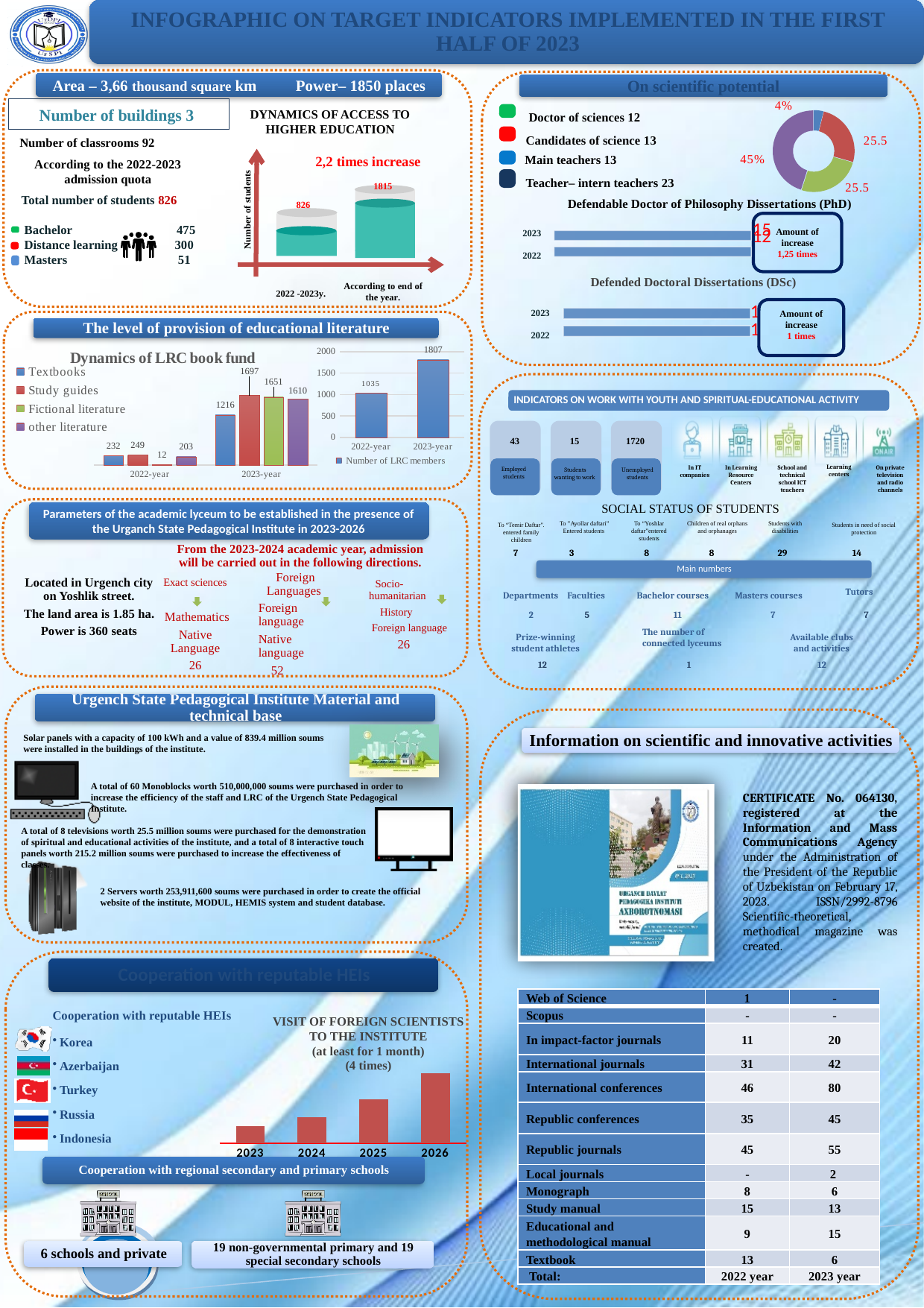
In the 'Dynamics of LRC book fund' chart, what is the value for Fictional literature in 2022-year? 12 In the 'Visit of foreign scientists to the institute' chart, do the values rise or fall from 2023 to 2026? rise In the 'Dynamics of LRC book fund' chart, which category has the highest value in 2023-year? Study guides What kind of chart is the 'Number of LRC members' chart? bar chart In the 'Number of LRC members' chart, what is the difference between 2023-year and 2022-year? 772 In the 'Dynamics of LRC book fund' chart, what is the difference between Textbooks in 2023-year and Textbooks in 2022-year? 984 In the 'Dynamics of access to higher education' chart, what is the value for 2022-2023y.? 826 How many series does the legend of the 'Dynamics of LRC book fund' chart list? 4 In the 'Dynamics of LRC book fund' chart, what is the value for Study guides in 2023-year? 1697 In the 'Dynamics of LRC book fund' chart, which category has the lowest value in 2022-year? Fictional literature In the 'Number of LRC members' chart, what is the value for 2023-year? 1807 In the 'Defendable Doctor of Philosophy Dissertations (PhD)' chart, which year has the larger value, 2023 or 2022? 2023